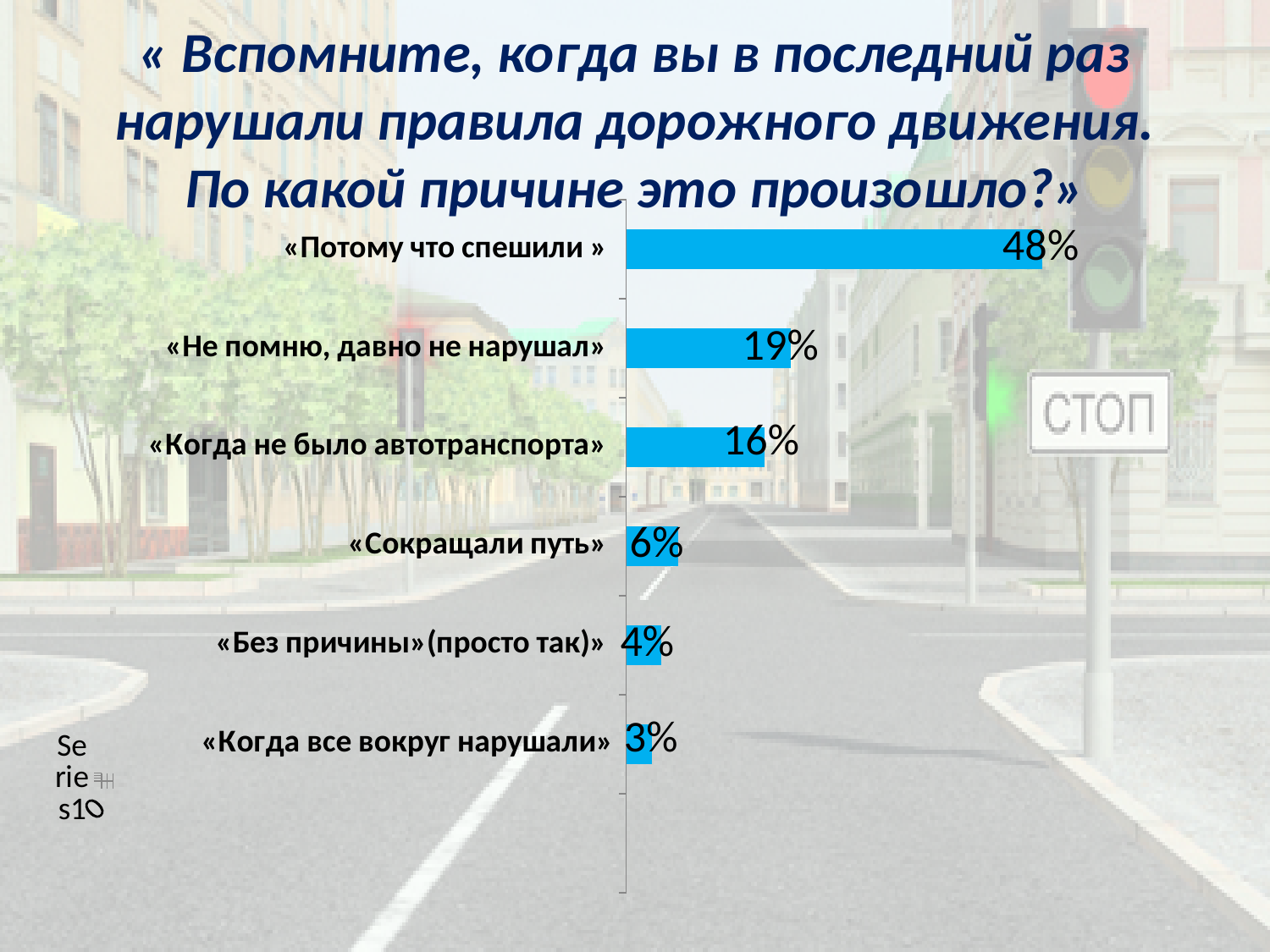
How many categories are shown in the chart? 6 What kind of chart is shown on the slide? bar chart Which is larger, the value for «Не помню, давно не нарушал» or «Когда не было автотранспорта»? «Не помню, давно не нарушал» What value is shown for «Не помню, давно не нарушал»? 19% Which category has the lowest value? «Когда все вокруг нарушали» What value is shown for «Когда не было автотранспорта»? 16% What value is shown for «Потому что спешили »? 48% What is the difference between the values for «Потому что спешили » and «Не помню, давно не нарушал»? 29% Which category has the highest value? «Потому что спешили » What is the difference between the values for «Сокращали путь» and «Без причины»(просто так)»? 2% What value is shown for «Когда все вокруг нарушали»? 3% What value is shown for «Сокращали путь»? 6%